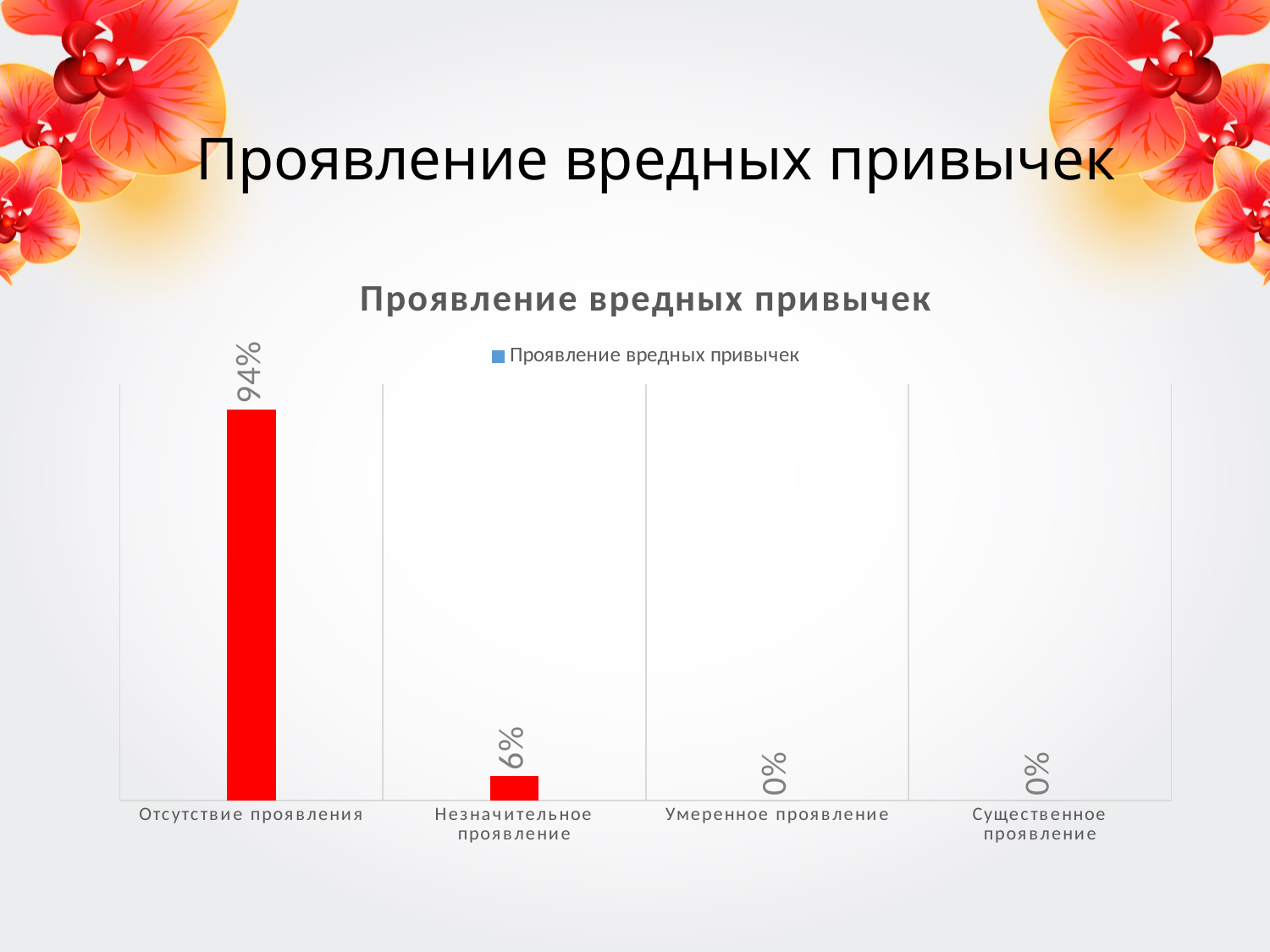
What is the value for Незначительное проявление? 6% What is the value for Отсутствие проявления? 94% Which is larger, the value for Незначительное проявление or the value for Умеренное проявление? Незначительное проявление Which category has the highest value? Отсутствие проявления What is the title of the chart? Проявление вредных привычек How many series does the legend list? 1 What is the value for Существенное проявление? 0% How many categories are shown on the x axis? 4 What kind of chart is shown? bar chart Do the values rise or fall from left to right along the x axis? fall What is the value for Умеренное проявление? 0% What is the difference between the values for Отсутствие проявления and Незначительное проявление? 88%